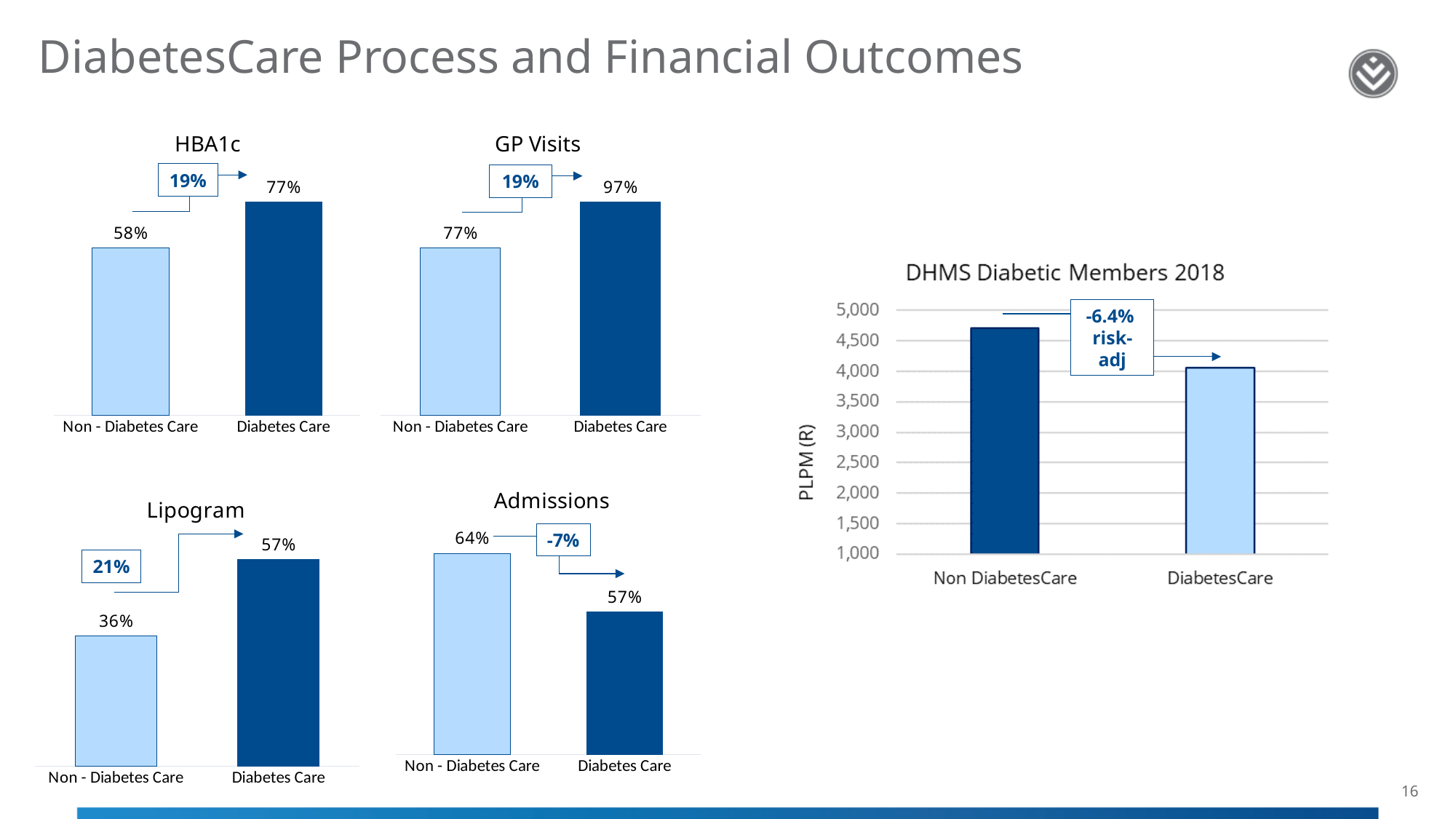
In the HBA1c chart, what is the difference between the Diabetes Care and Non - Diabetes Care values? 19% In the GP Visits chart, what is the value for Non - Diabetes Care? 77% In the GP Visits chart, which category has the higher value? Diabetes Care In the Lipogram chart, what is the value for Non - Diabetes Care? 36% In the DHMS Diabetic Members 2018 chart, is the value for DiabetesCare greater or less than 4,500? less In the Lipogram chart, what is the difference between the Diabetes Care and Non - Diabetes Care values? 21% In the Admissions chart, which category has the lower value? Diabetes Care In the Admissions chart, what is the difference between the Non - Diabetes Care and Diabetes Care values? 7% In the DHMS Diabetic Members 2018 chart, is the value for Non DiabetesCare greater or less than 4,500? greater What is the y-axis label of the DHMS Diabetic Members 2018 chart? PLPM (R) What kind of chart is the DHMS Diabetic Members 2018 chart? Bar chart In the HBA1c chart, what is the value for Diabetes Care? 77%